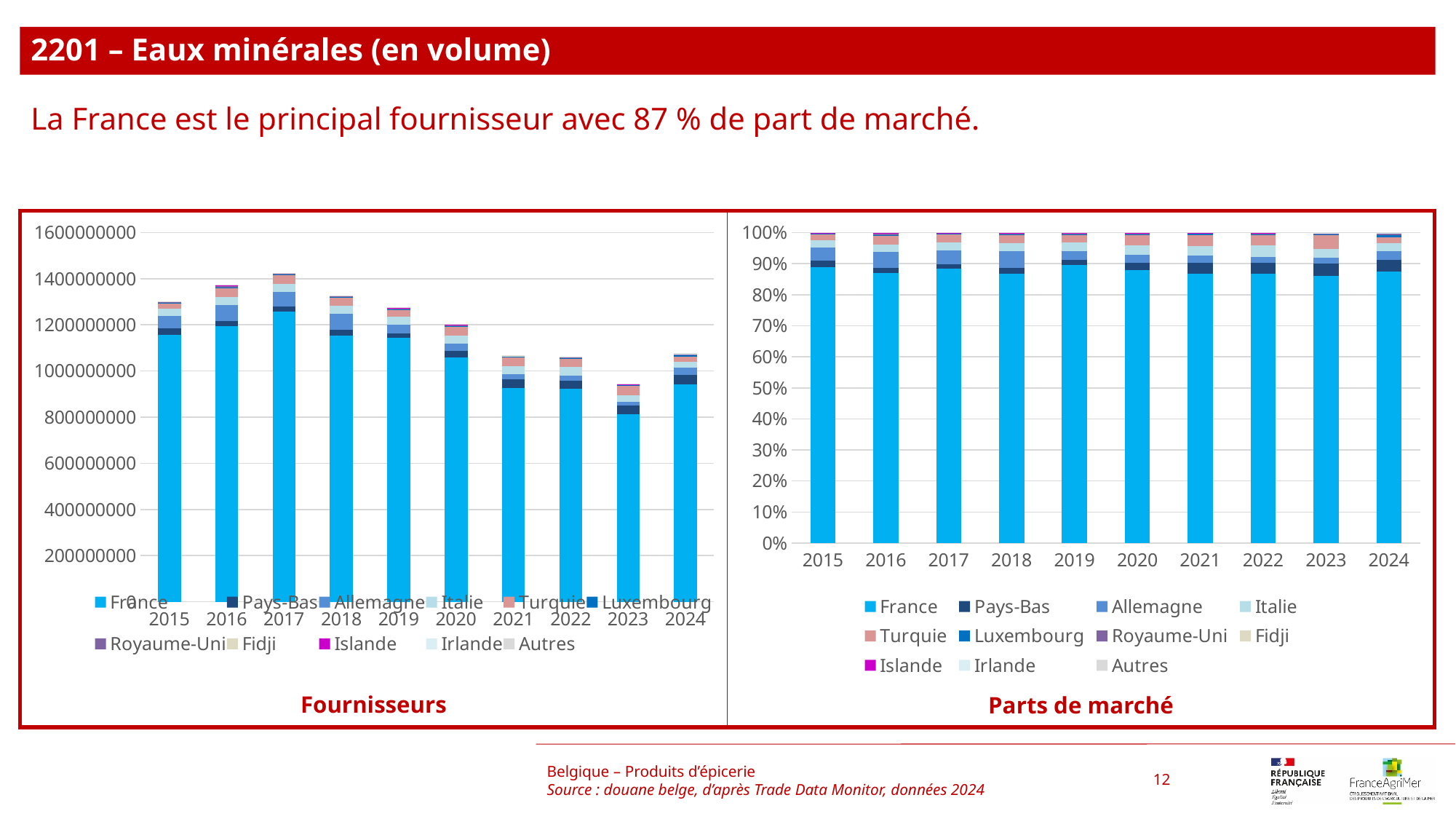
In the 'Fournisseurs' chart, which year has the highest total bar? 2017 What kind of chart is the 'Fournisseurs' chart on the left? Stacked bar chart In the 'Fournisseurs' chart, is the total for 2015 greater or less than 1200000000? greater In the 'Parts de marché' chart, is France's share in 2019 greater or less than 80%? greater In the 'Fournisseurs' chart, is the total for 2023 greater or less than 1000000000? less How many years are shown on the x axis of the 'Fournisseurs' chart? 10 How many series does the legend of the 'Parts de marché' chart list? 11 In the 'Fournisseurs' chart, which year has the lowest total bar? 2023 What is the title shown under the right-hand chart? Parts de marché In the 'Parts de marché' chart, which series takes the largest share in every year? France In the 'Fournisseurs' chart, which total bar is larger, 2015 or 2020? 2015 In the 'Fournisseurs' chart, do the total bars rise or fall from 2017 to 2023? fall